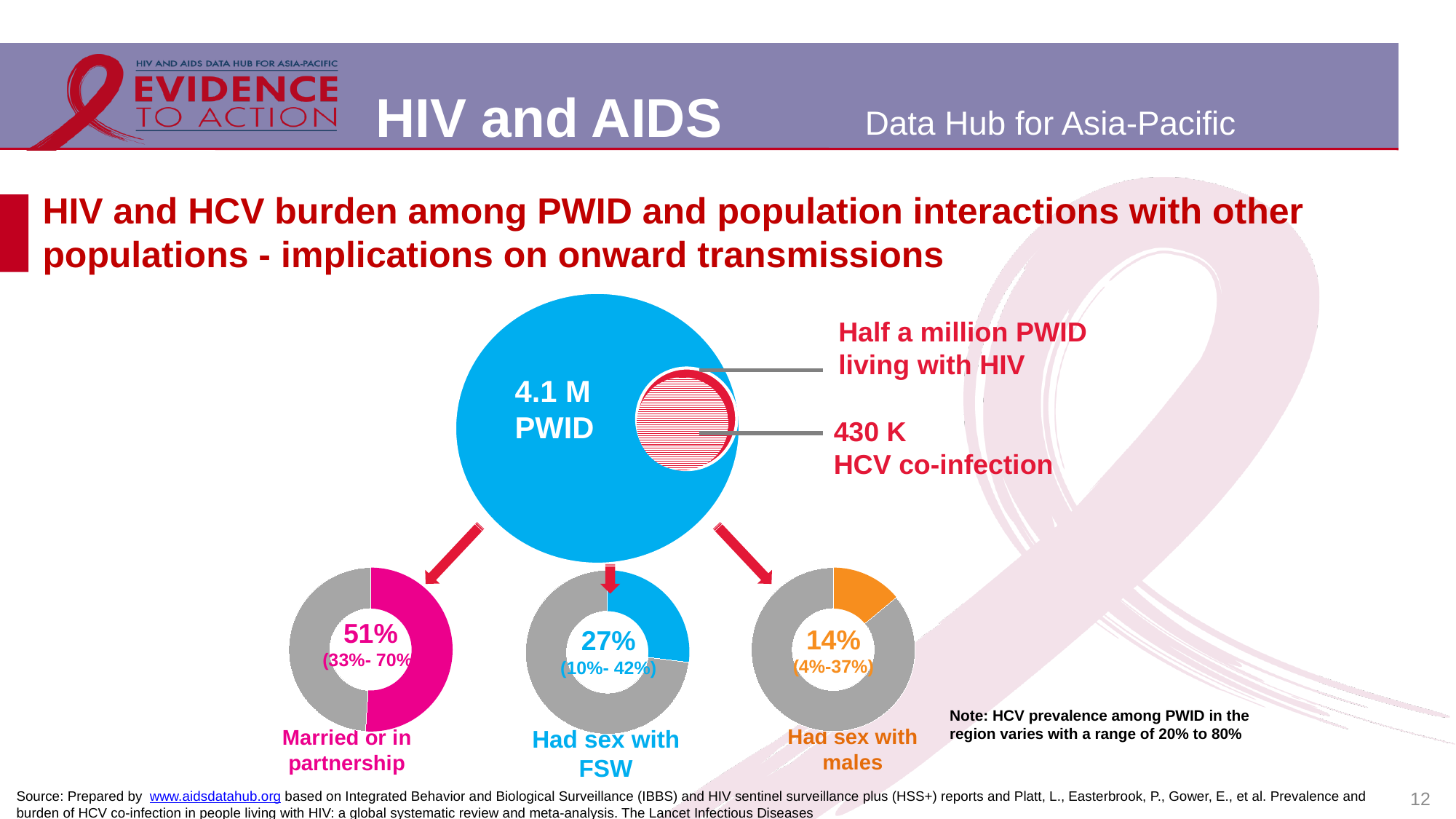
How many donut charts are shown at the bottom of the slide? 3 Across the three donut charts, which population interaction has the lowest percentage? Had sex with males Across the three donut charts, which population interaction has the highest percentage? Married or in partnership What colour is the highlighted segment in the 'Had sex with males' donut chart? Orange In the 'Married or in partnership' donut chart, what percentage is shown? 51% In the 'Had sex with males' donut chart, what percentage is shown? 14% What range is given beneath the 14% value in the 'Had sex with males' donut chart? 4%-37% Which is larger: the percentage in the 'Had sex with FSW' donut chart or the 'Had sex with males' donut chart? Had sex with FSW In the 'Had sex with FSW' donut chart, what percentage is shown? 27% What type of chart is used to show the 51%, 27% and 14% values? Donut (pie) chart What is the difference in percentage points between the 'Married or in partnership' donut chart and the 'Had sex with FSW' donut chart? 24 percentage points What range is given beneath the 51% value in the 'Married or in partnership' donut chart? 33%- 70%